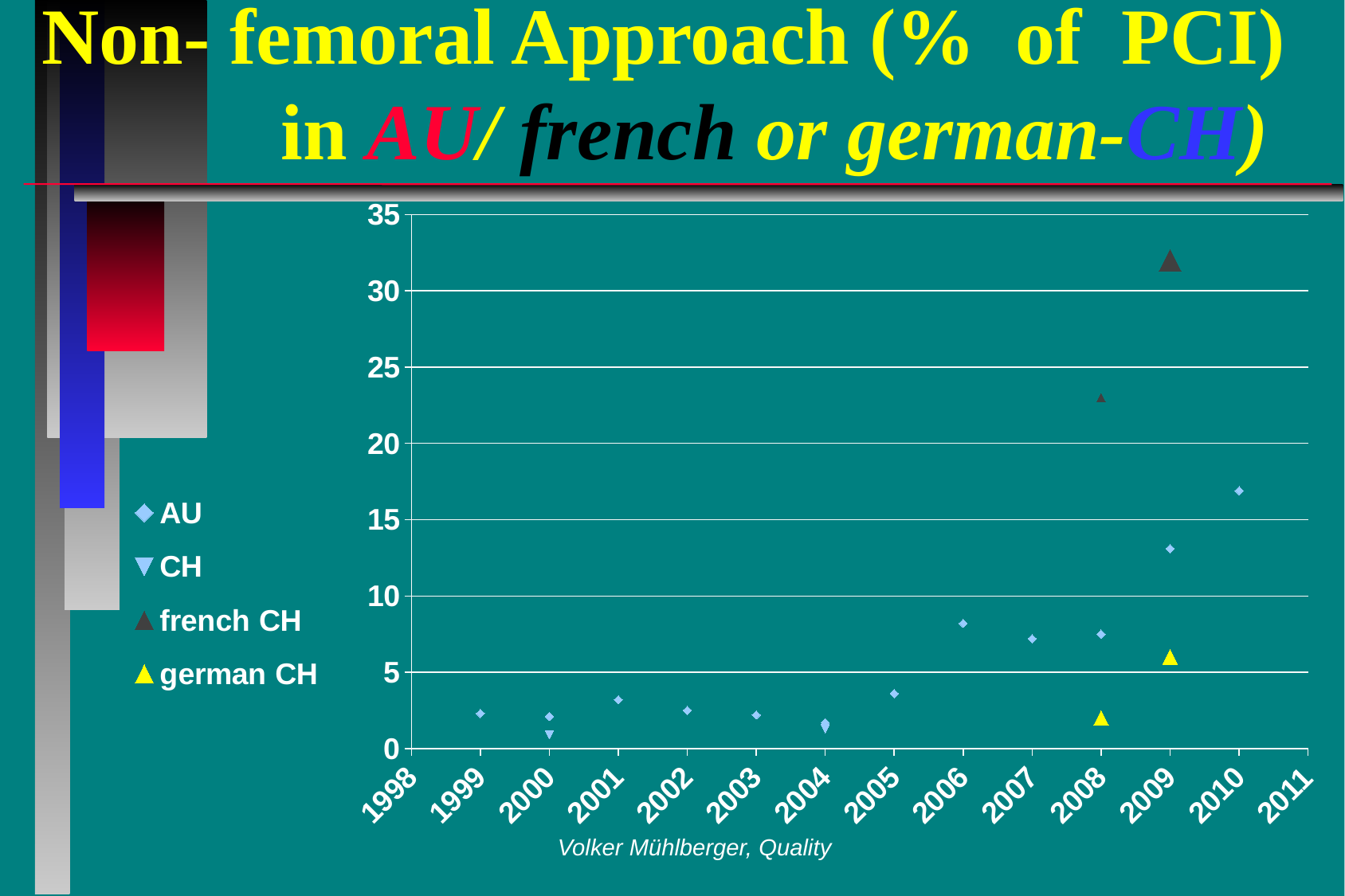
In which year does the AU series reach its highest value? 2010 How many series does the legend list? 4 What kind of chart is shown on the slide? scatter chart Does the AU series generally rise or fall from 2005 to 2010? rise Is the value for french CH in 2009 greater or less than 30? greater Which series has the highest plotted point on the chart? french CH Is the value for french CH in 2008 greater or less than 20? greater Is the value for AU in 2006 greater or less than 10? less In 2009, which is larger: the value for french CH or the value for AU? french CH Which series are listed in the legend? AU, CH, french CH, german CH